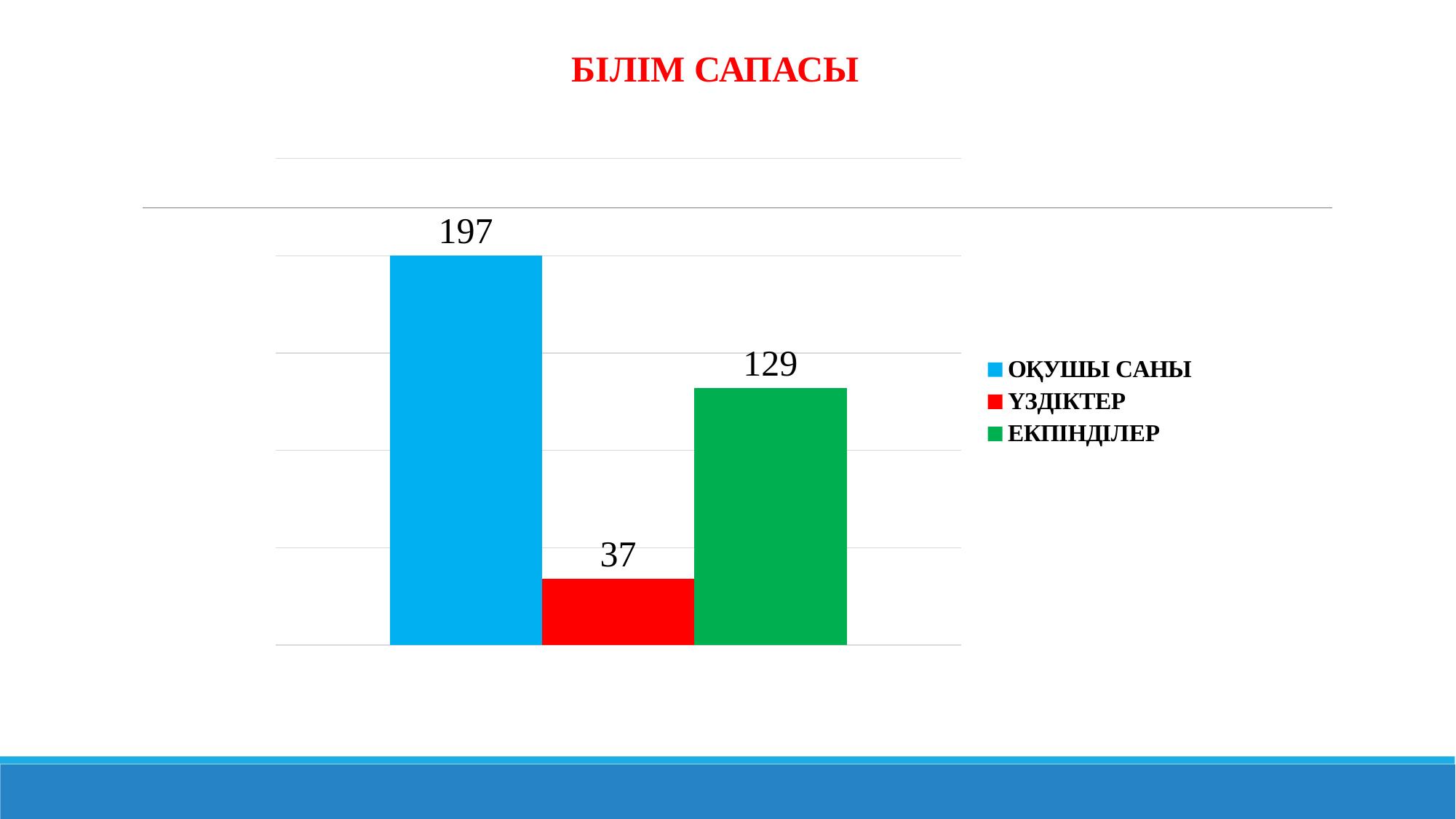
What is the value for ОҚУШЫ САНЫ? 197 How many series does the legend list? 3 What is the title of the slide? БІЛІМ САПАСЫ What is the difference between the values for ОҚУШЫ САНЫ and ЕКПІНДІЛЕР? 68 What is the value for ЕКПІНДІЛЕР? 129 What kind of chart is shown on the slide? Bar chart What is the value for ҮЗДІКТЕР? 37 Which series has the lowest value? ҮЗДІКТЕР How many bars are plotted on the chart? 3 Which is larger, the value for ЕКПІНДІЛЕР or the value for ҮЗДІКТЕР? ЕКПІНДІЛЕР Which series has the highest value? ОҚУШЫ САНЫ What is the difference between the values for ЕКПІНДІЛЕР and ҮЗДІКТЕР? 92